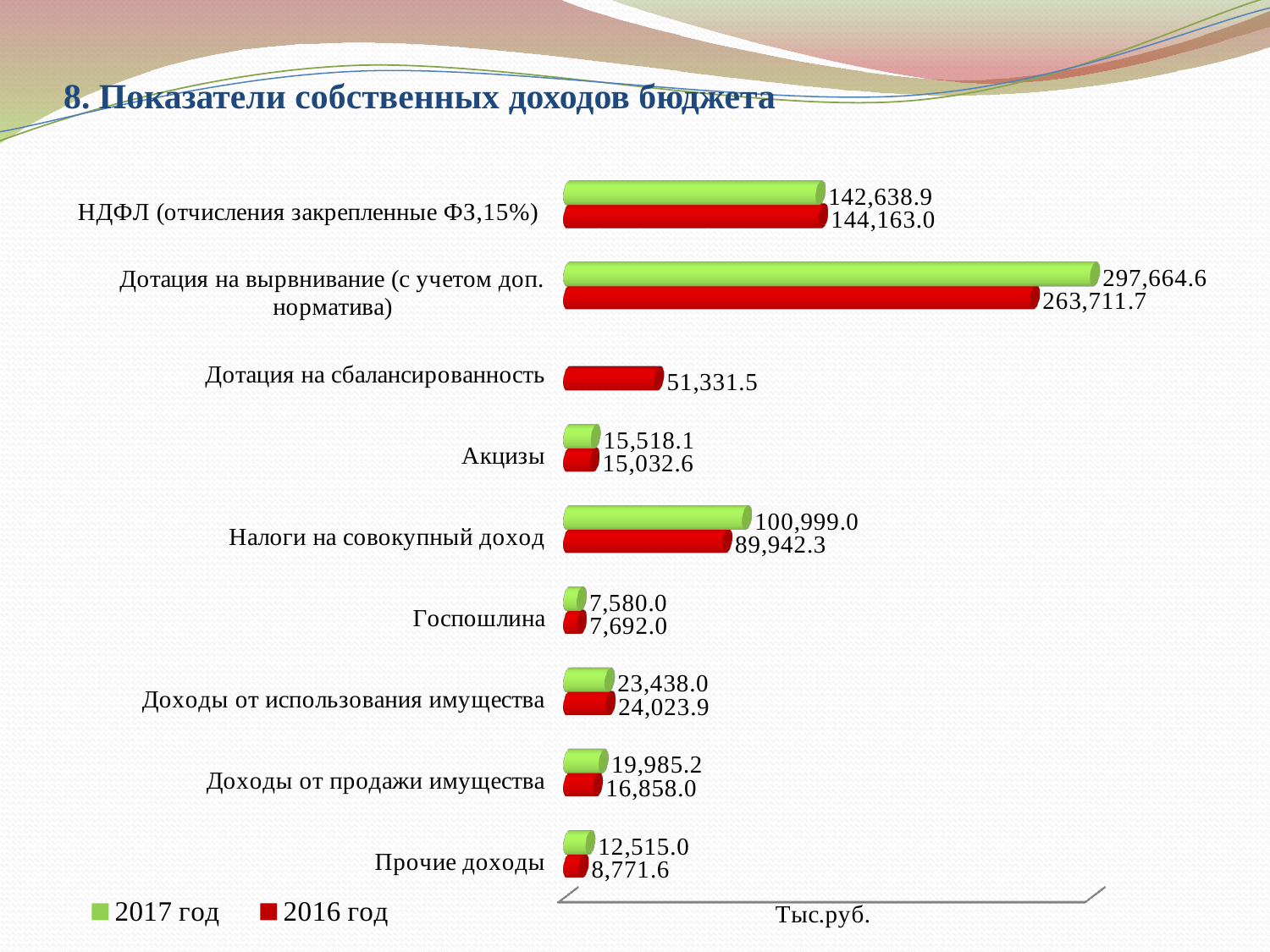
What is the difference between the 2017 год and 2016 год values for Дотация на вырвнивание (с учетом доп. норматива)? 33,952.9 What is the value for НДФЛ (отчисления закрепленные ФЗ,15%) in the 2017 год series? 142,638.9 For Доходы от продажи имущества, which series has the larger value, 2017 год or 2016 год? 2017 год How many series does the legend list? 2 What is the 2017 год value for Прочие доходы? 12,515.0 How many categories are shown on the chart? 9 What is the difference between the 2017 год and 2016 год values for Налоги на совокупный доход? 11,056.7 Which category has the highest value in the 2017 год series? Дотация на вырвнивание (с учетом доп. норматива) What kind of chart is shown on the slide? Bar chart What is the value for Дотация на сбалансированность in the 2016 год series? 51,331.5 What is the 2016 год value for Налоги на совокупный доход? 89,942.3 Which category has the lowest value in the 2016 год series? Госпошлина